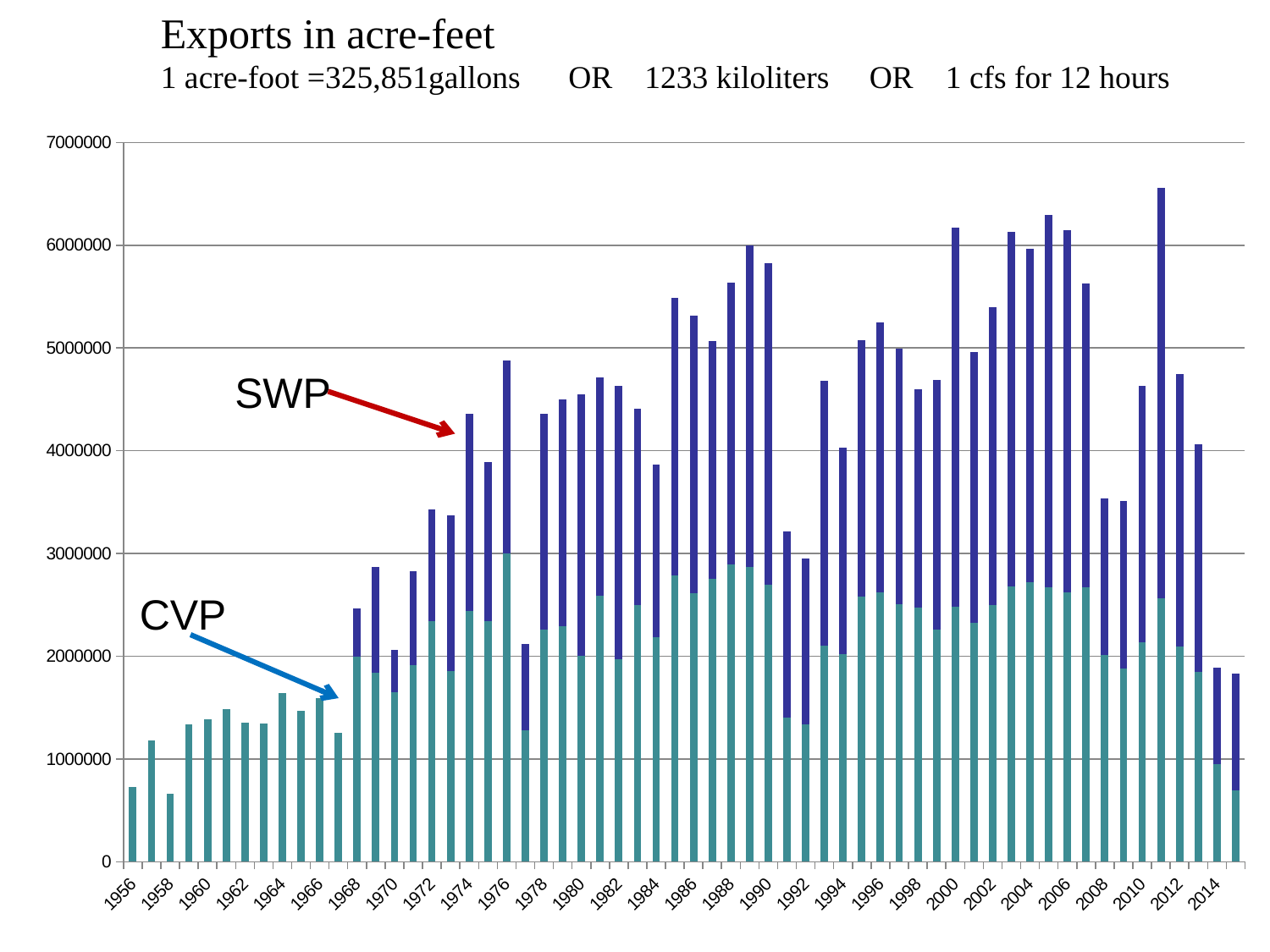
Which year has the larger total exports, 2011 or 2005? 2011 Is the total value for 1958 greater or less than 1000000? less Which series is shown in blue at the top of each stacked bar? SWP What is the title of the chart? Exports in acre-feet Is the total value for 2014 greater or less than 2000000? less What kind of chart is shown on the slide? Stacked bar chart Do total exports generally rise or fall from 1956 to 1968? rise Which year has the larger total exports, 2000 or 2001? 2000 Is the total value for 1990 greater or less than 5000000? greater How many series are plotted in the chart? 2 Which year has the highest total exports? 2011